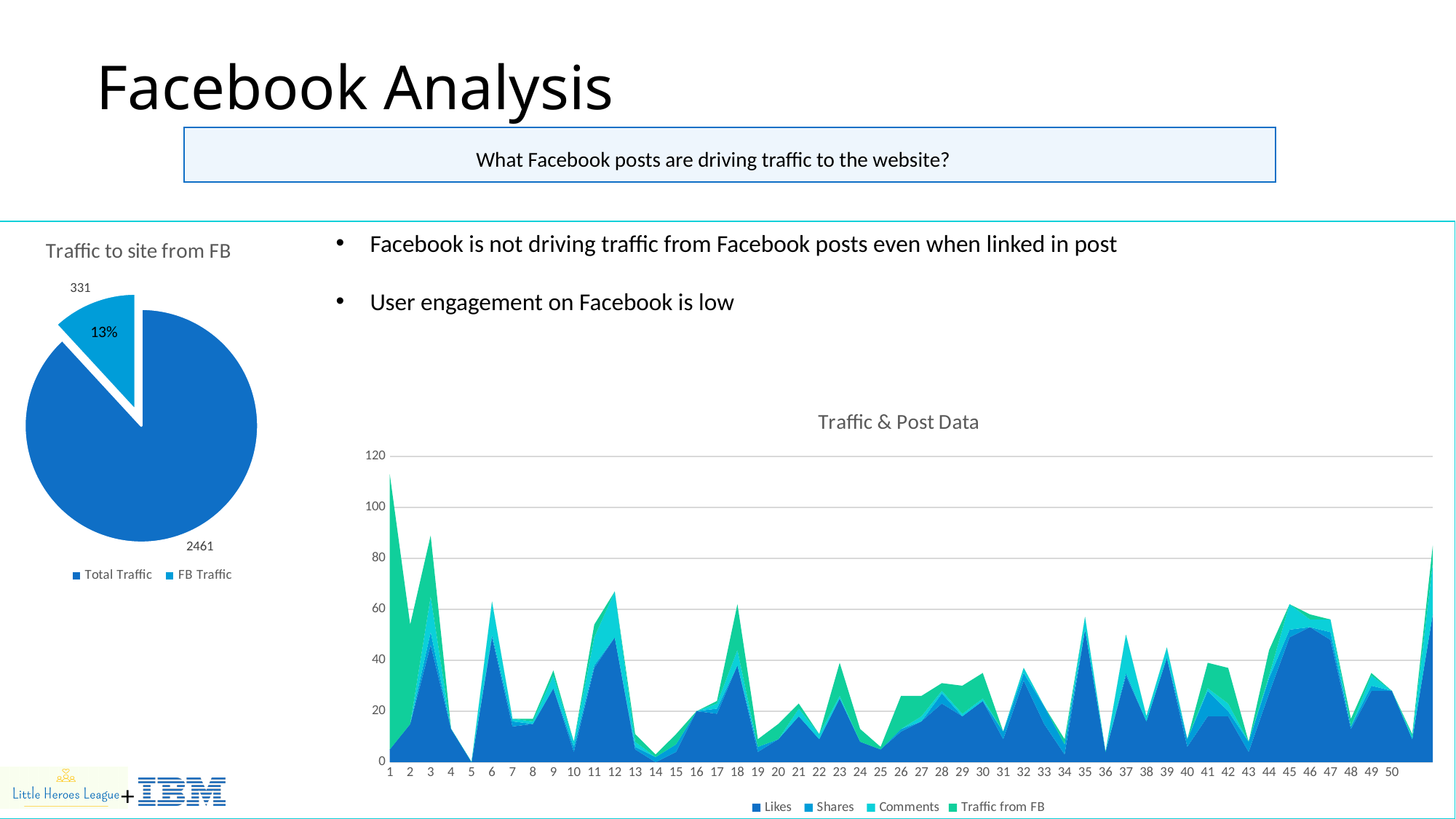
On the pie chart 'Traffic to site from FB', what is the difference between Total Traffic and FB Traffic? 2130 On the pie chart 'Traffic to site from FB', what value is shown for FB Traffic? 331 On the pie chart 'Traffic to site from FB', what percentage share is labelled on the FB Traffic slice? 13% On the 'Traffic & Post Data' chart, is the stacked total at point 1 greater or less than 100? greater On the 'Traffic & Post Data' chart, which series is listed last in the legend? Traffic from FB On the 'Traffic & Post Data' chart, is the stacked total at point 5 greater or less than 20? less On the pie chart 'Traffic to site from FB', how many entries does the legend list? 2 On the pie chart 'Traffic to site from FB', which slice is larger, Total Traffic or FB Traffic? Total Traffic On the 'Traffic & Post Data' chart, how many series does the legend list? 4 What kind of chart is the 'Traffic & Post Data' chart? Area chart On the 'Traffic & Post Data' chart, what is the highest value shown on the vertical axis? 120 On the pie chart 'Traffic to site from FB', what value is shown for Total Traffic? 2461